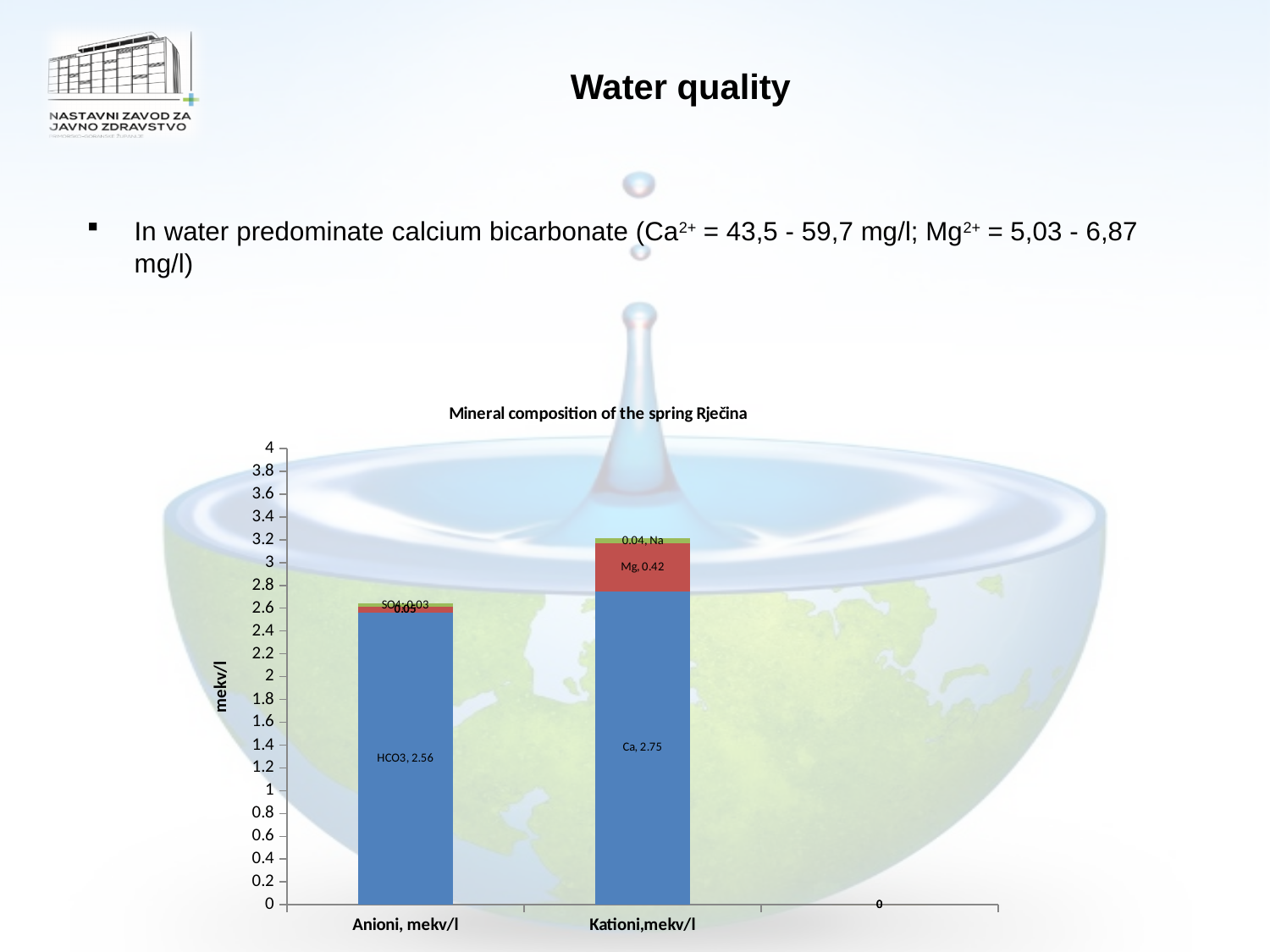
What is the title of the chart? Mineral composition of the spring Rječina Which is larger, the Ca value or the HCO3 value? Ca Is the total height of the Anioni bar greater or less than 3? less What is the value of Mg in the Kationi bar? 0.42 What is the total of the Kationi stacked bar (Ca + Mg + Na)? 3.21 What kind of chart is shown on the slide? Stacked bar chart What is the value of Ca in the Kationi bar? 2.75 How many labelled categories are shown on the x axis? 2 What is the difference between the Ca value and the HCO3 value? 0.19 What is the label on the vertical axis of the chart? mekv/l What is the value of HCO3 in the Anioni bar? 2.56 What is the value of Na in the Kationi bar? 0.04